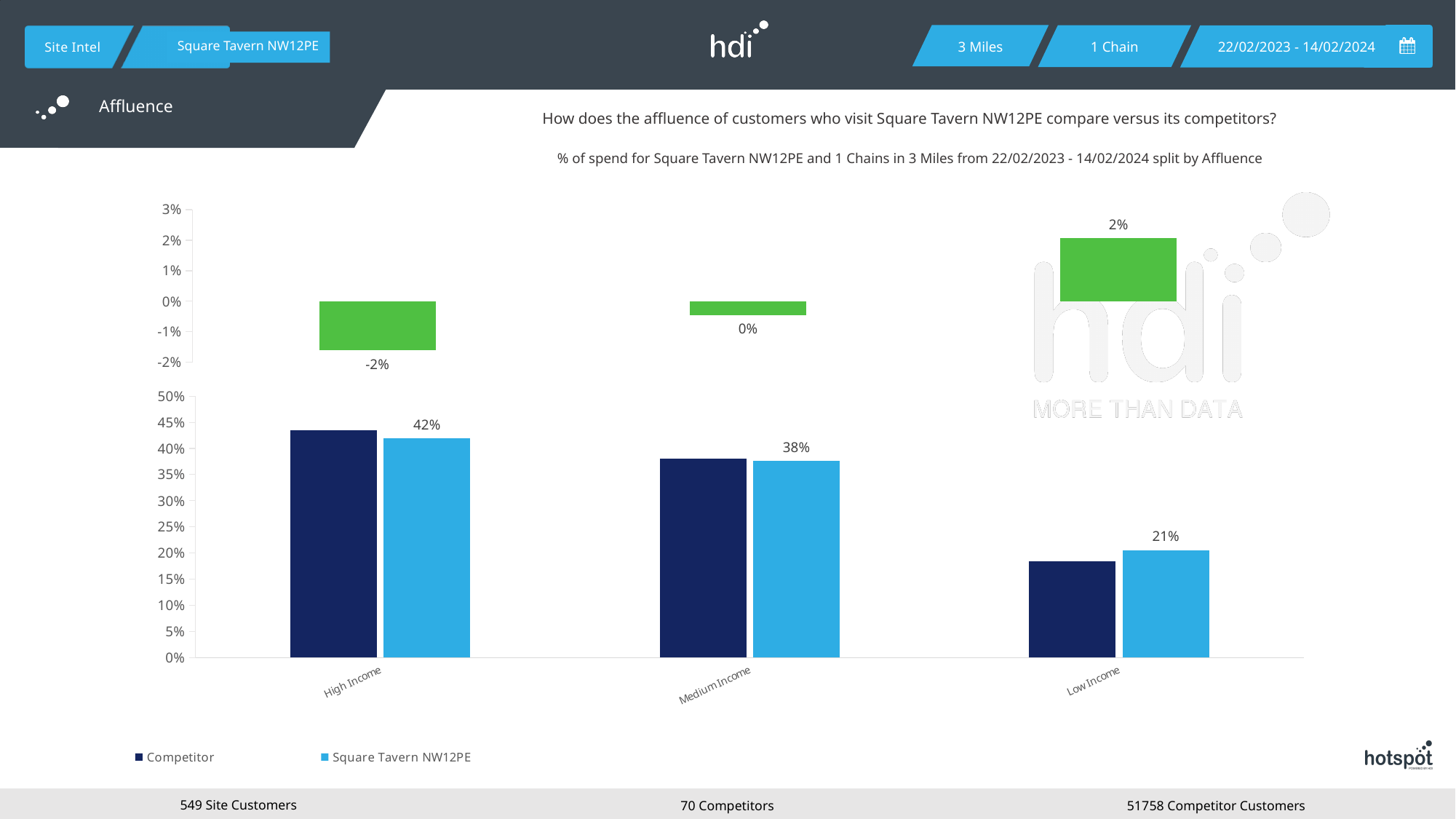
In the bottom chart, which category has the lowest value for Square Tavern NW12PE? Low Income In the bottom chart, what is the difference between the Square Tavern NW12PE values for High Income and Low Income? 21% How many series does the legend of the bottom chart list? 2 In the bottom chart, what is the value for Square Tavern NW12PE in the Medium Income category? 38% In the bottom chart, is the Competitor value for Low Income greater or less than 20%? less In the top chart, what is the value shown for the High Income category? -2% In the bottom chart, what is the value for Square Tavern NW12PE in the Low Income category? 21% In the bottom chart, is the Competitor value for High Income greater or less than 40%? greater In the bottom chart, which category has the highest value for Square Tavern NW12PE? High Income In the bottom chart, which is larger for Low Income: the Competitor bar or the Square Tavern NW12PE bar? Square Tavern NW12PE In the bottom chart, what is the value for Square Tavern NW12PE in the High Income category? 42% In the top chart, what is the value shown for the Low Income category? 2%